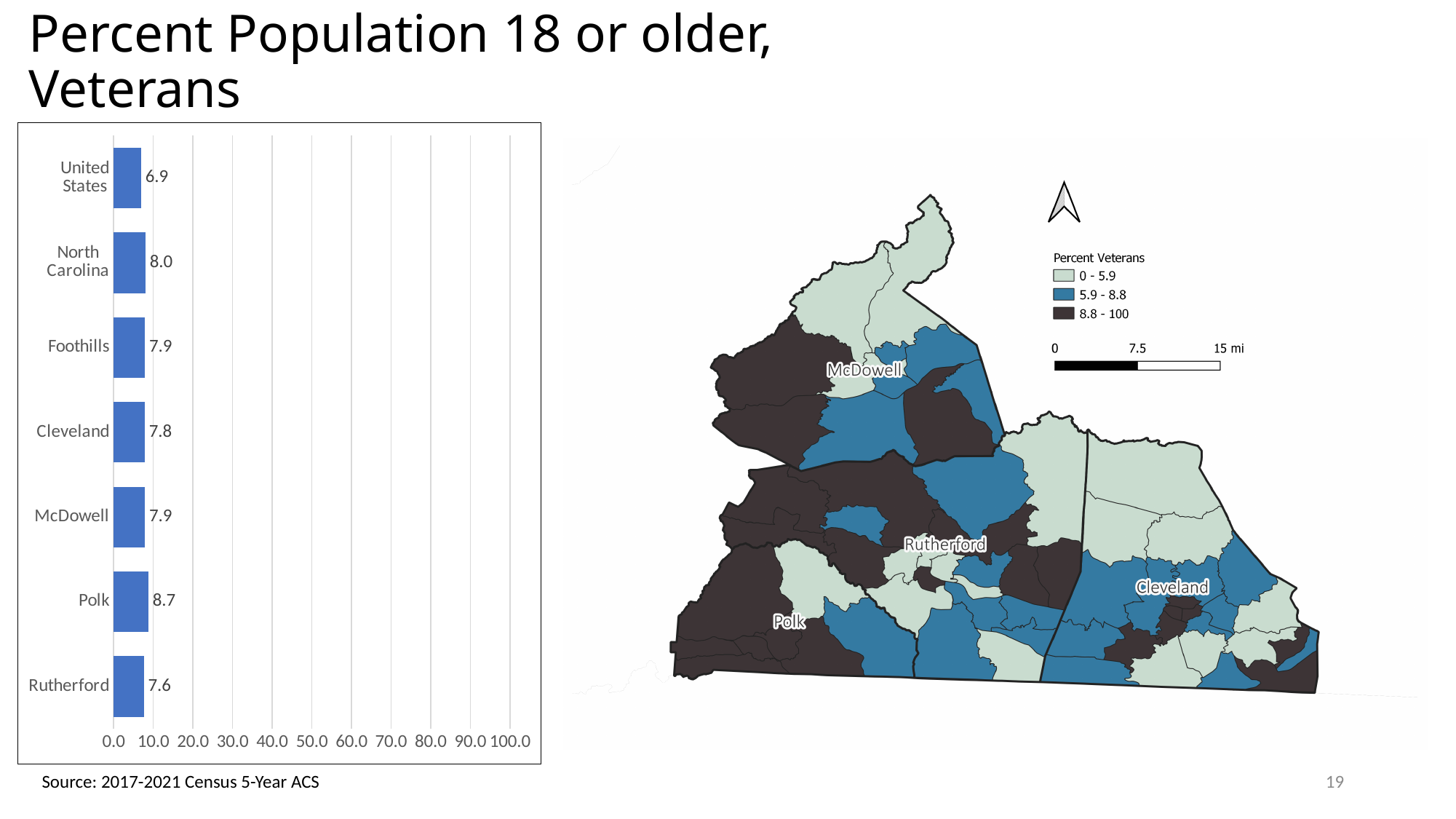
What is the value for Polk in the bar chart? 8.7 What is the highest value shown on the x axis of the bar chart? 100.0 Which category has the highest value in the bar chart? Polk What is the difference between the values for Polk and Rutherford in the bar chart? 1.1 Which has a larger value in the bar chart, Cleveland or Polk? Polk What is the value for Rutherford in the bar chart? 7.6 What is the value for the United States in the bar chart? 6.9 What is the difference between the values for North Carolina and the United States in the bar chart? 1.1 How many categories are shown in the bar chart? 7 Which category has the lowest value in the bar chart? United States What is the value for North Carolina in the bar chart? 8.0 What kind of chart is shown on the left of the slide? Bar chart